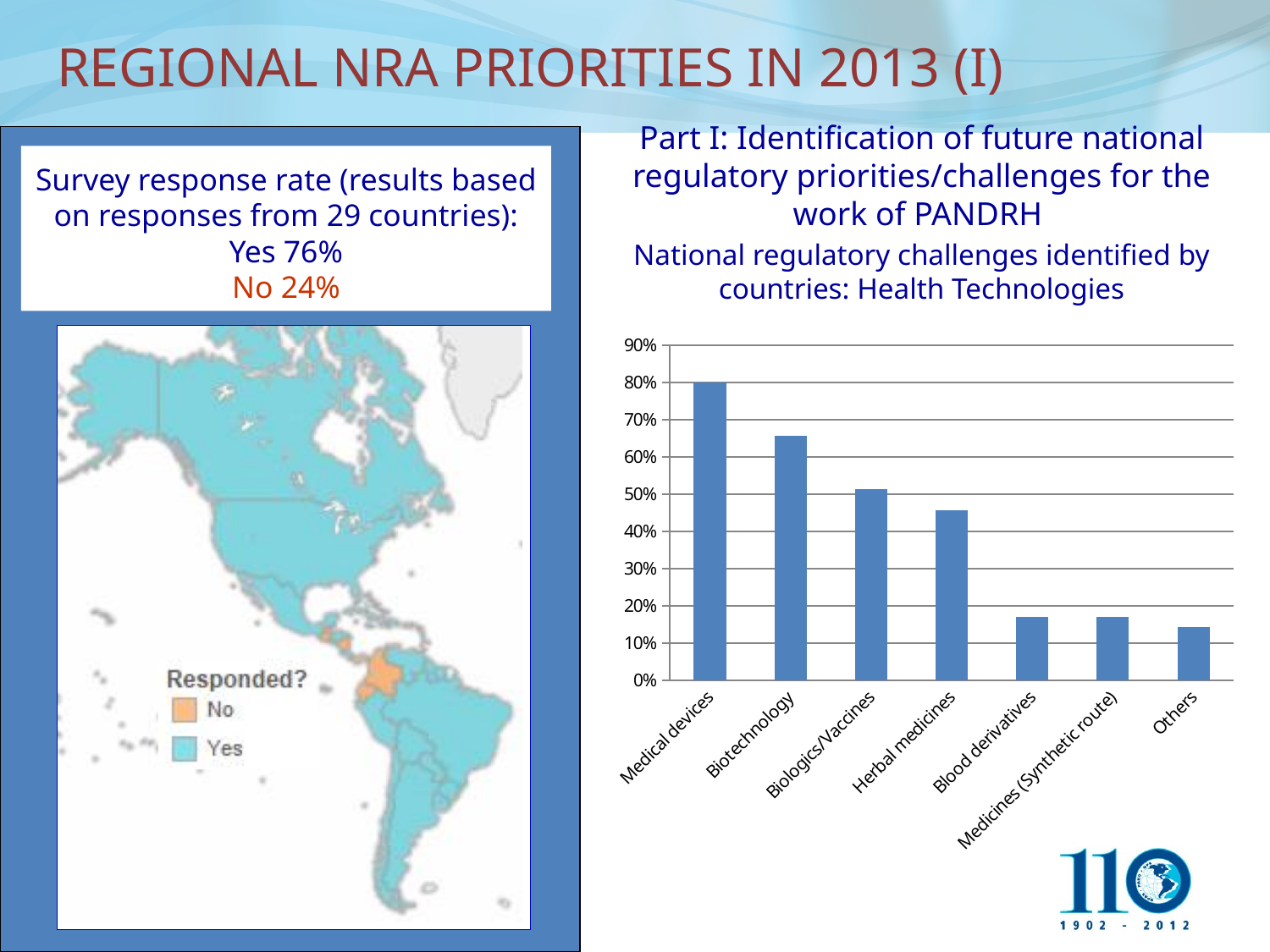
Which category has the highest value in the Health Technologies bar chart? Medical devices Which category has the lowest value in the Health Technologies bar chart? Others In the Health Technologies bar chart, is the value for Others greater or less than 10%? greater What kind of chart is used to show the national regulatory challenges identified by countries for Health Technologies? bar chart In the Health Technologies bar chart, is the value for Blood derivatives greater or less than 20%? less In the Health Technologies bar chart, is the value for Biotechnology greater or less than 60%? greater In the Health Technologies bar chart, what is the value for Medical devices? 80% What is the highest value shown on the y axis of the Health Technologies bar chart? 90% Do the values in the Health Technologies bar chart rise or fall from left to right along the x axis? fall In the Health Technologies bar chart, which is larger: Biotechnology or Herbal medicines? Biotechnology How many categories are shown on the x axis of the Health Technologies bar chart? 7